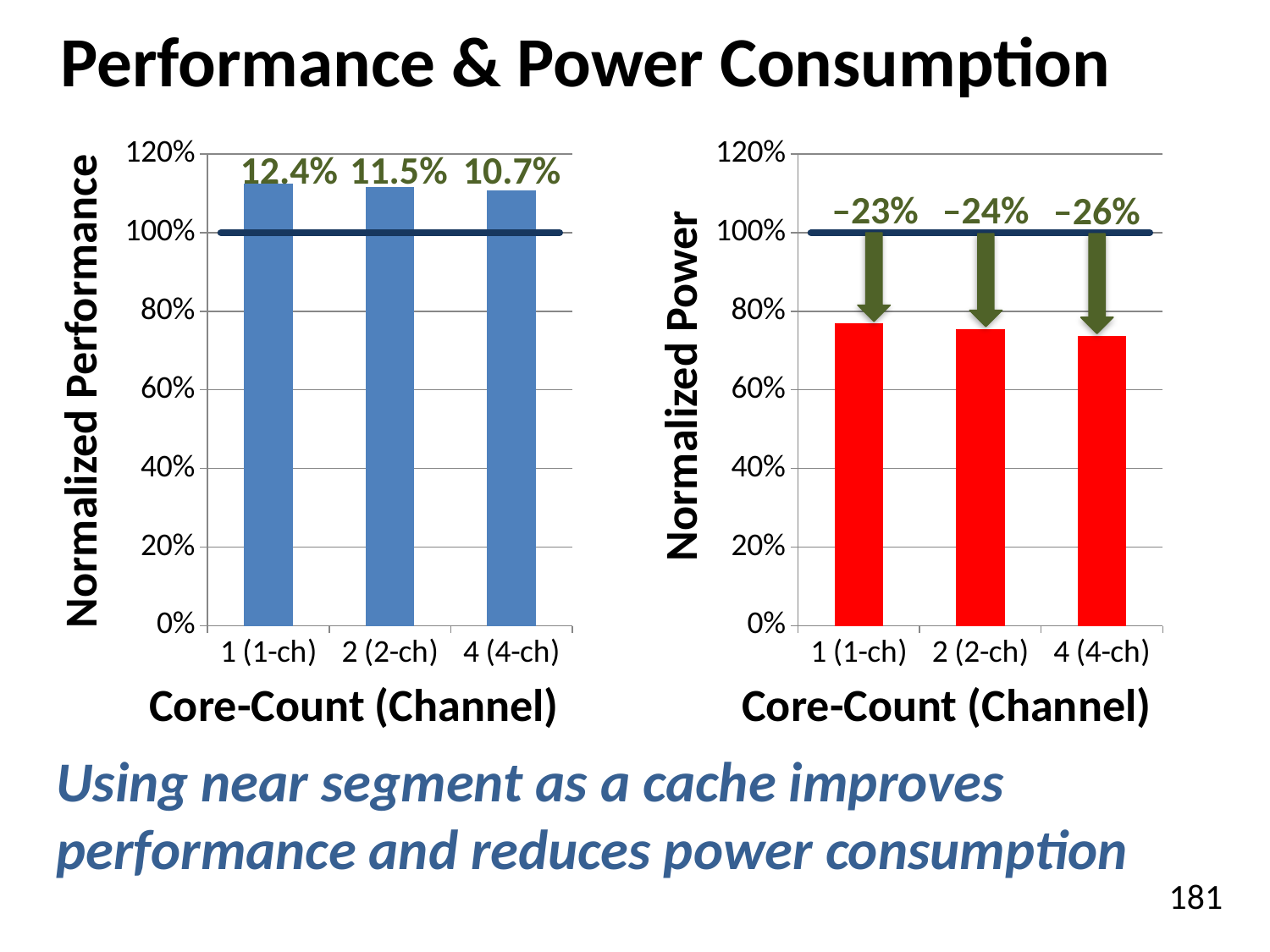
What type of chart is the right chart (Normalized Power)? Bar chart On the right chart (Normalized Power), what label is shown above the bar for 4 (4-ch)? –26% On the left chart (Normalized Performance), is the value for 2 (2-ch) greater or less than 100%? greater On the right chart (Normalized Power), is the value for 4 (4-ch) greater or less than 60%? greater On the left chart (Normalized Performance), what percentage label is shown above the bar for 4 (4-ch)? 10.7% On the left chart (Normalized Performance), which core-count configuration has the highest bar? 1 (1-ch) On the left chart (Normalized Performance), what percentage label is shown above the bar for 1 (1-ch)? 12.4% On the right chart (Normalized Power), what label is shown above the bar for 2 (2-ch)? –24% On the right chart (Normalized Power), do the bar values rise or fall as the core count increases from 1 to 4? Fall How many core-count categories are shown on the left chart (Normalized Performance)? 3 On the right chart (Normalized Power), which core-count configuration has the lowest bar? 4 (4-ch) On the right chart (Normalized Power), is the value for 1 (1-ch) greater or less than 80%? less